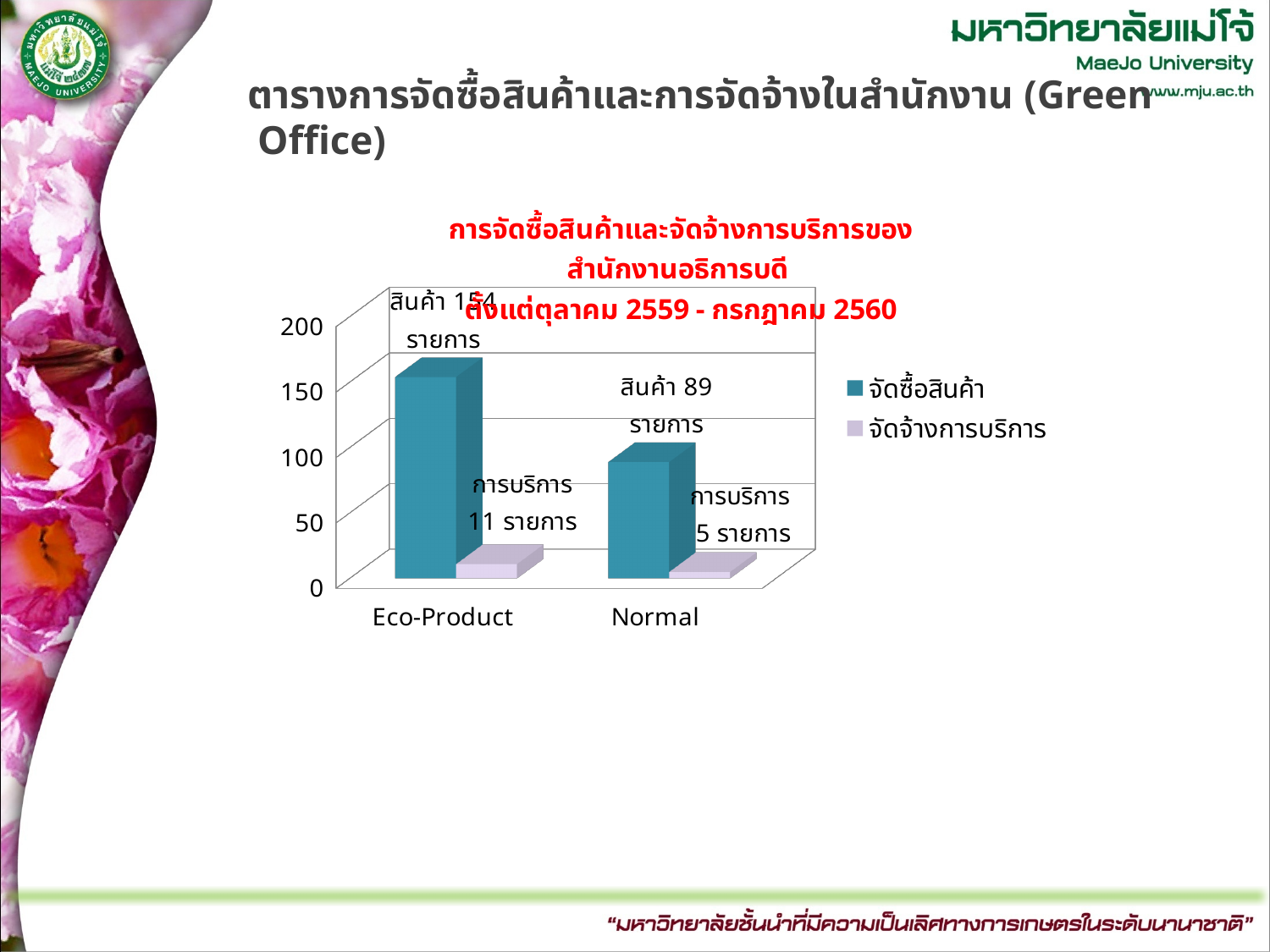
Which category has the higher value for จัดซื้อสินค้า, Eco-Product or Normal? Eco-Product What kind of chart is shown on the slide? bar chart Is the value for จัดซื้อสินค้า in the Normal category greater or less than 100? less What is the value for จัดจ้างการบริการ (services hired) in the Eco-Product category? 11 รายการ How many categories are shown on the x axis of the chart? 2 What is the value for จัดจ้างการบริการ (services hired) in the Normal category? 5 รายการ Is the value for จัดซื้อสินค้า in the Eco-Product category greater or less than 100? greater How many series does the chart legend list? 2 What is the value for จัดซื้อสินค้า (goods purchased) in the Normal category? 89 รายการ What are the two category labels on the x axis of the chart? Eco-Product and Normal What is the difference between the จัดจ้างการบริการ values for Eco-Product and Normal? 6 รายการ Which category has the lowest value for จัดจ้างการบริการ? Normal